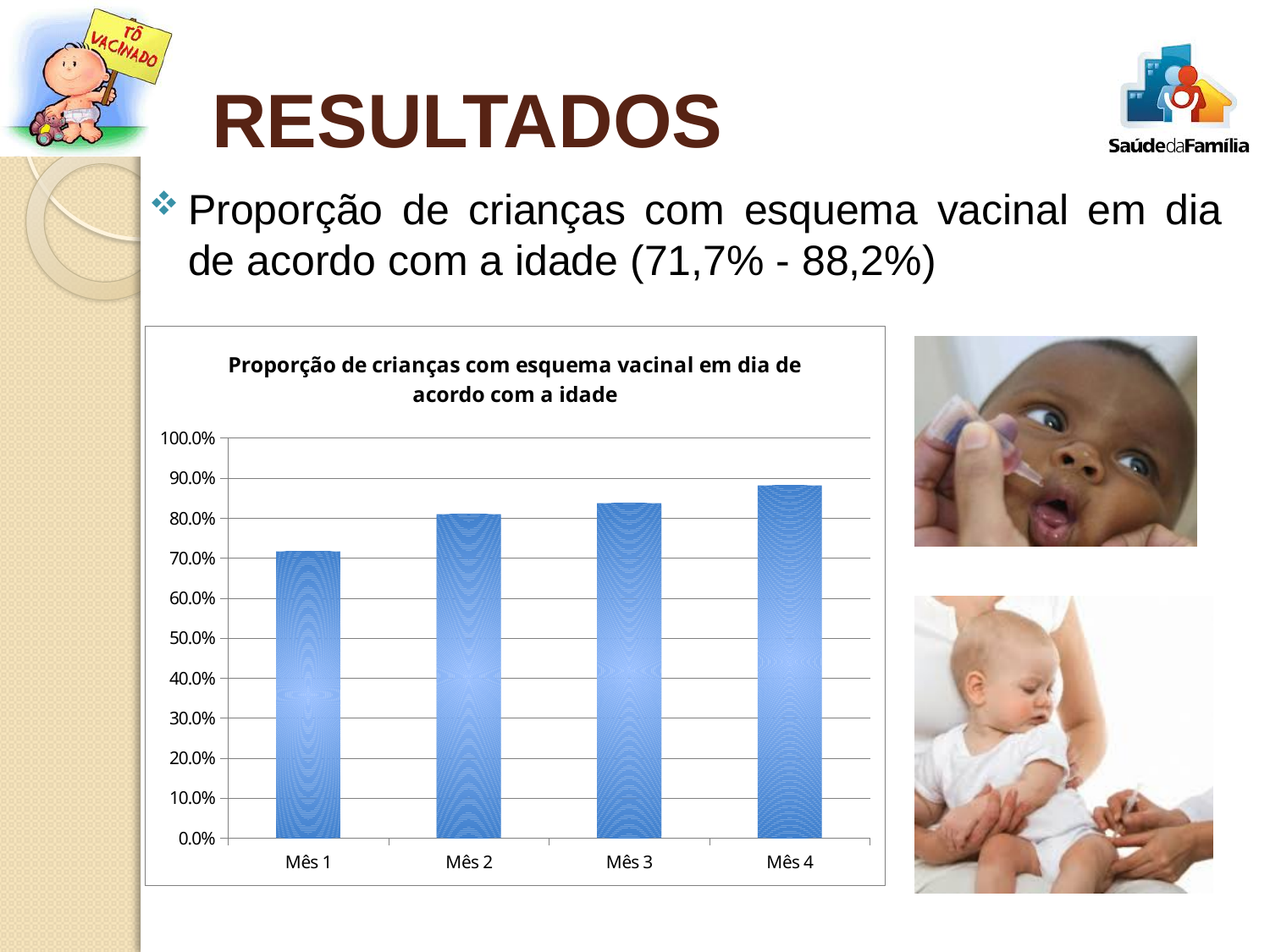
Which is larger, the value for Mês 1 or the value for Mês 3? Mês 3 Is the value for Mês 2 greater or less than 90.0%? less Which month has the highest proportion of children with an up-to-date vaccination schedule? Mês 4 Do the values rise or fall from Mês 1 to Mês 4? rise How many categories (months) are plotted on the chart? 4 What is the title of the chart? Proporção de crianças com esquema vacinal em dia de acordo com a idade Is the value for Mês 4 greater or less than 90.0%? less Is the value for Mês 3 greater or less than 80.0%? greater Which month has the lowest proportion of children with an up-to-date vaccination schedule? Mês 1 What kind of chart is shown on the slide? bar chart